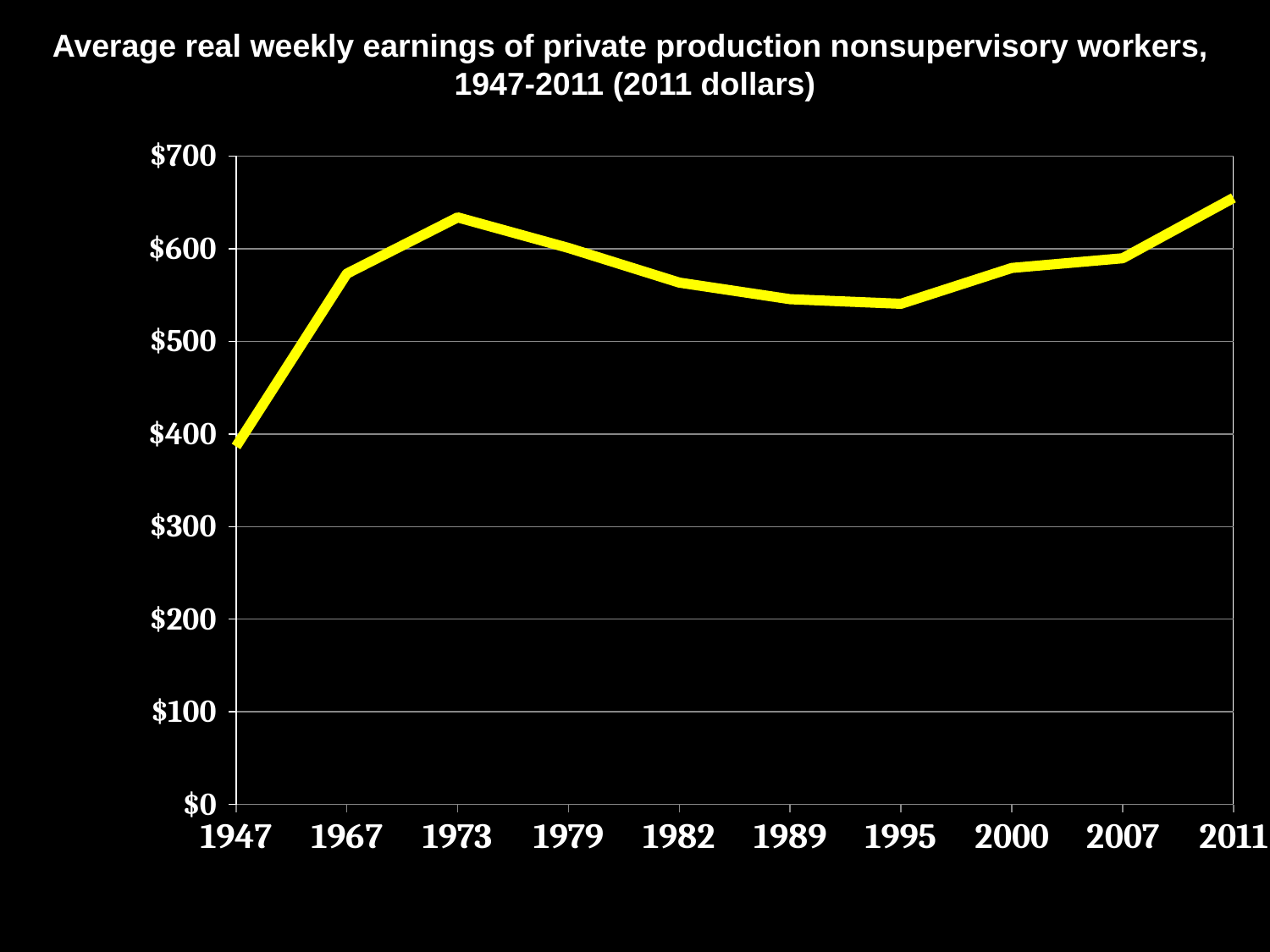
Is the value for 1947 greater or less than $400? less Which year has the lowest average real weekly earnings on the chart? 1947 What kind of chart is shown on the slide? line chart Is the value for 1973 greater or less than $600? greater Which year has higher average real weekly earnings, 1947 or 1967? 1967 Is the value for 1995 greater or less than $500? greater Which year has the highest average real weekly earnings on the chart? 2011 In what dollars are the earnings on the chart expressed, according to the title? 2011 dollars How many years are labelled along the x axis of the chart? 10 Do average real weekly earnings rise or fall between 1973 and 1995? fall Do average real weekly earnings rise or fall between 1995 and 2011? rise